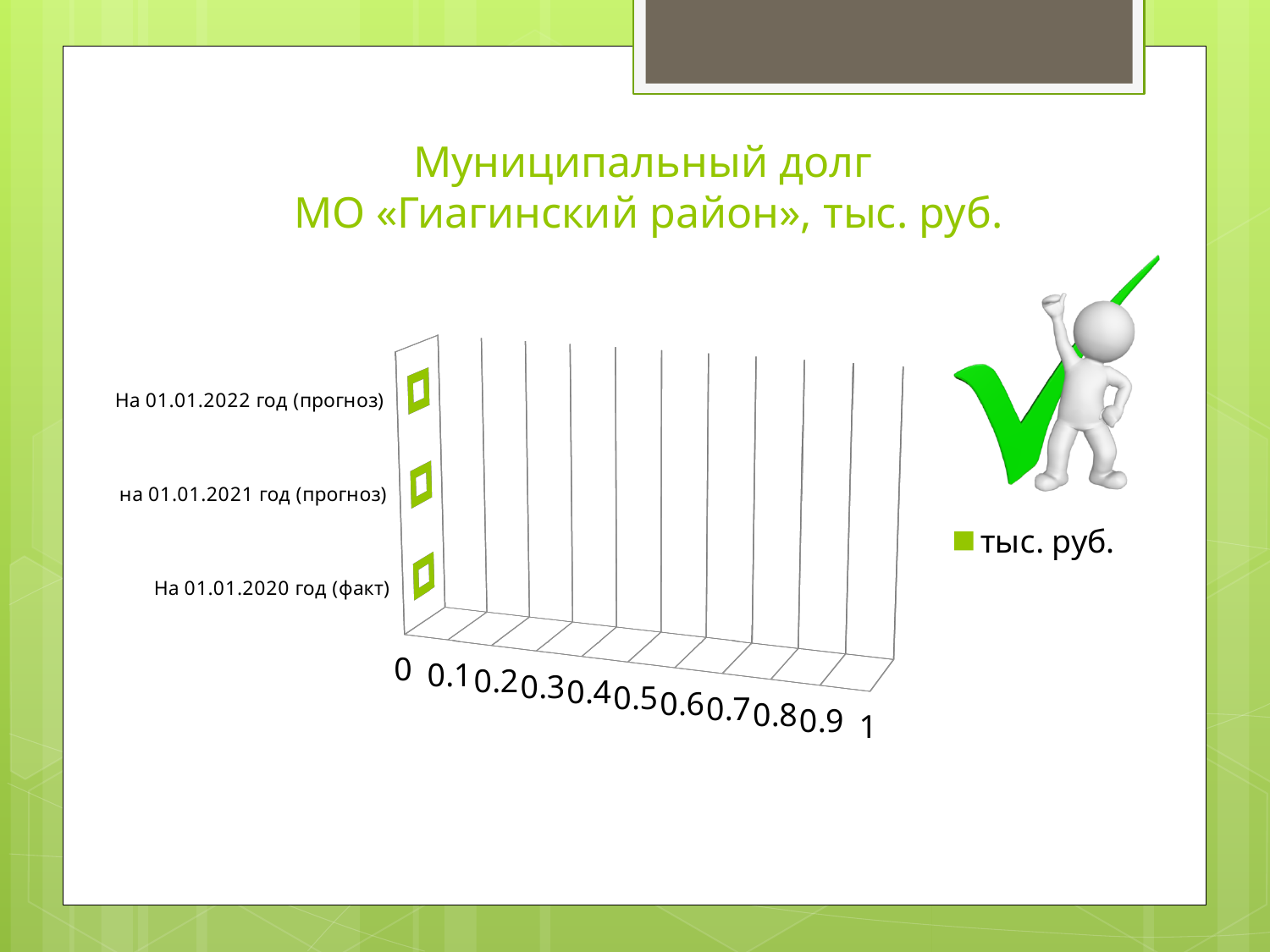
Is the value for "На 01.01.2020 год (факт)" greater or less than 0.5? less Do the values rise, fall or stay the same from "На 01.01.2020 год (факт)" to "На 01.01.2022 год (прогноз)"? stay the same Is the value for "На 01.01.2022 год (прогноз)" greater or less than 0.5? less What is the value for "На 01.01.2022 год (прогноз)"? 0 What is the value for "на 01.01.2021 год (прогноз)"? 0 What kind of chart is shown on the slide? bar chart What is the difference between the values for "На 01.01.2022 год (прогноз)" and "На 01.01.2020 год (факт)"? 0 How many categories are shown on the chart? 3 What is the series name shown in the chart legend? тыс. руб. How many series does the chart legend list? 1 What is the title of the chart on the slide? Муниципальный долг МО «Гиагинский район», тыс. руб. What is the value for "На 01.01.2020 год (факт)"? 0